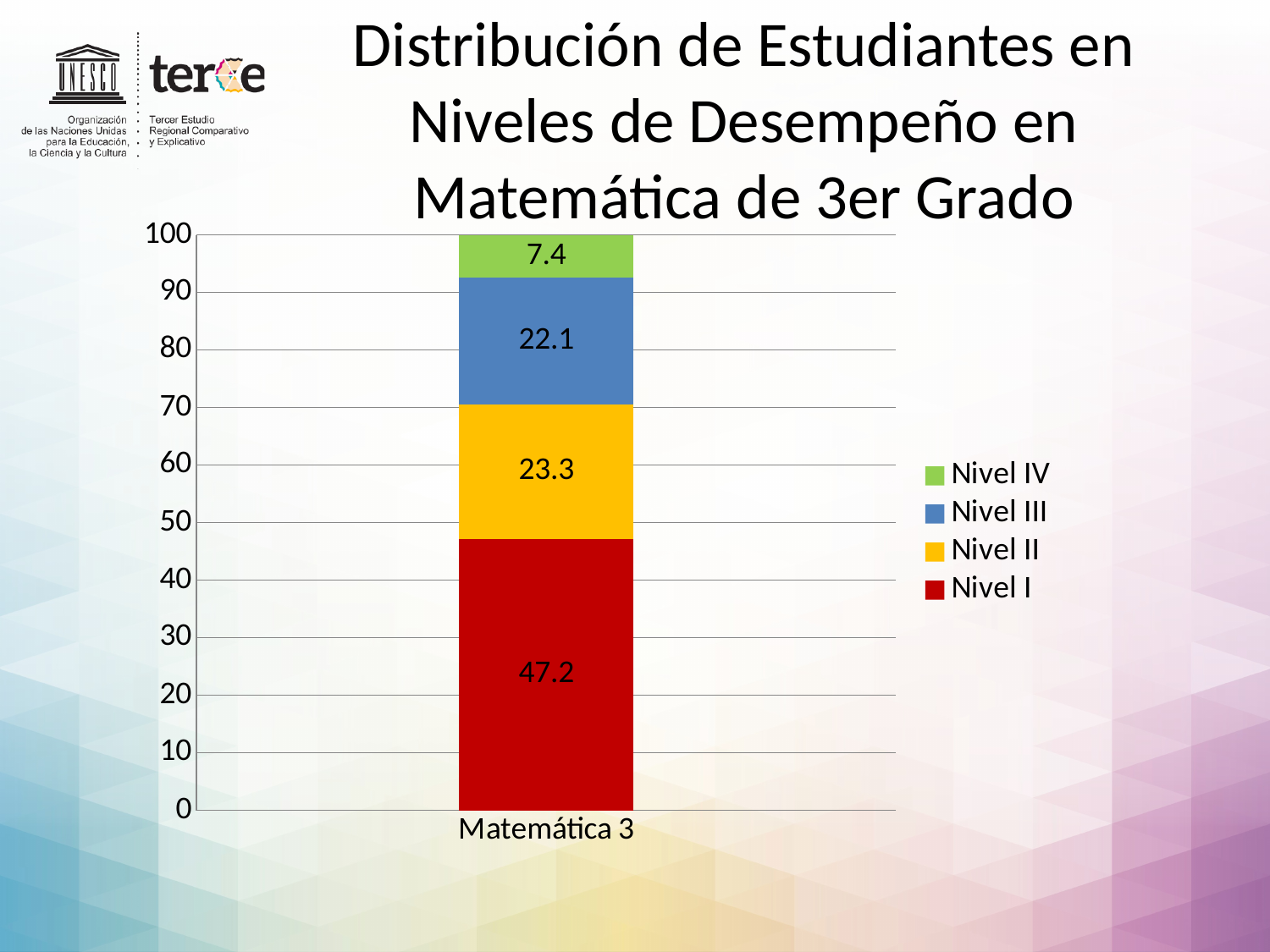
What is the value for Nivel III in the Matemática 3 bar? 22.1 How many series does the legend list? 4 What is the value for Nivel I in the Matemática 3 bar? 47.2 What is the difference between the Nivel I and Nivel IV values? 39.8 Which level has the smallest share of students in the Matemática 3 bar? Nivel IV What kind of chart is shown on the slide? Stacked bar chart Which is larger, the value for Nivel II or the value for Nivel III? Nivel II What is the value for Nivel II in the Matemática 3 bar? 23.3 What colour represents Nivel I in the chart? Red Which level has the largest share of students in the Matemática 3 bar? Nivel I What is the value for Nivel IV in the Matemática 3 bar? 7.4 What is the total of the stacked Matemática 3 bar? 100